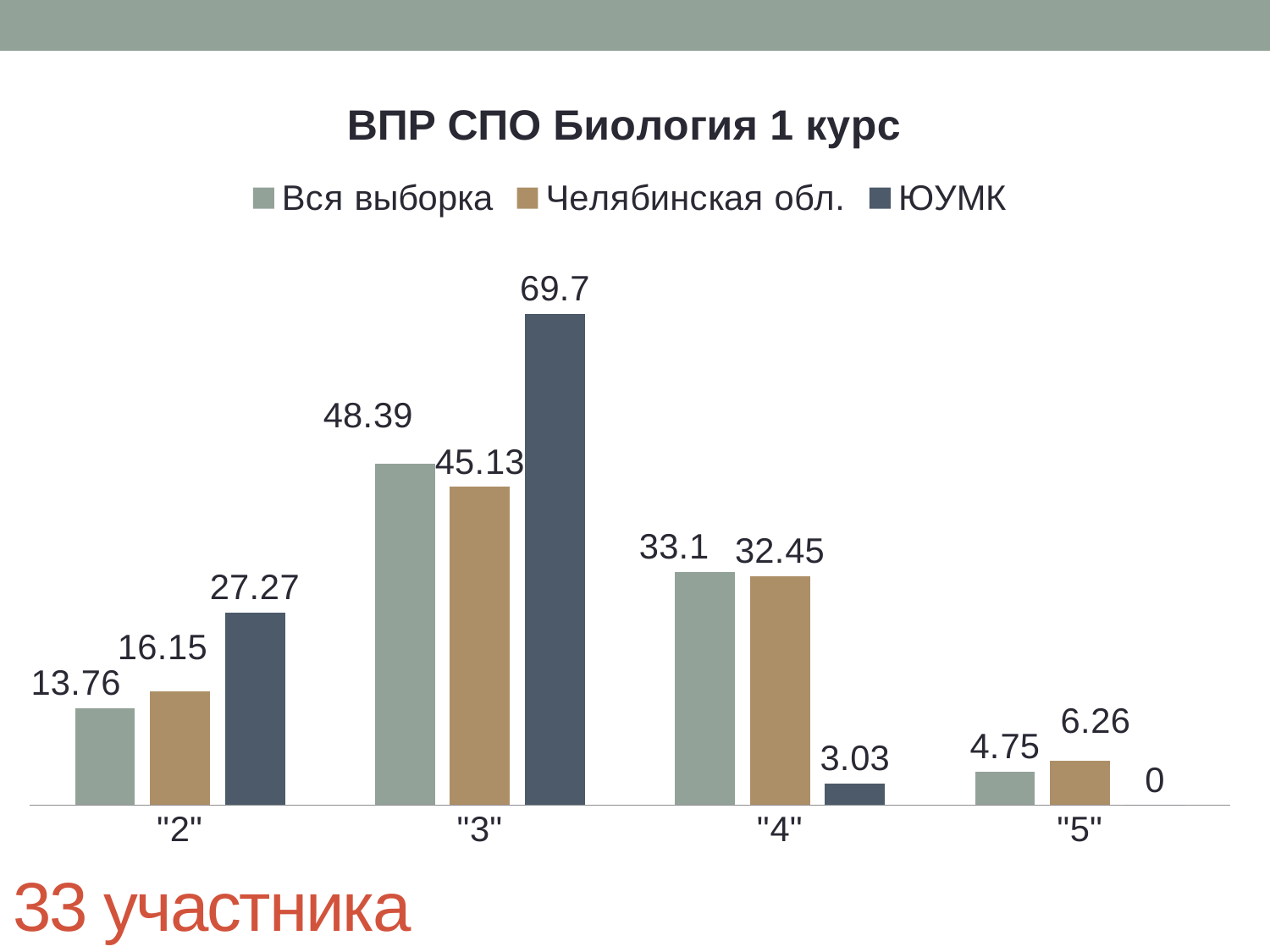
What is the title of the chart? ВПР СПО Биология 1 курс What is the difference between the ЮУМК value and the Вся выборка value in category "3"? 21.31 How many categories are shown on the x axis? 4 In which category does the Вся выборка series have its lowest value? "5" What is the value for ЮУМК in category "4"? 3.03 What is the value for ЮУМК in category "3"? 69.7 What kind of chart is shown on the slide? Bar chart How many series does the legend list? 3 What is the value for Челябинская обл. in category "5"? 6.26 Which is larger in category "4": Вся выборка or Челябинская обл.? Вся выборка In which category does the ЮУМК series reach its highest value? "3" What is the value for Вся выборка in category "2"? 13.76